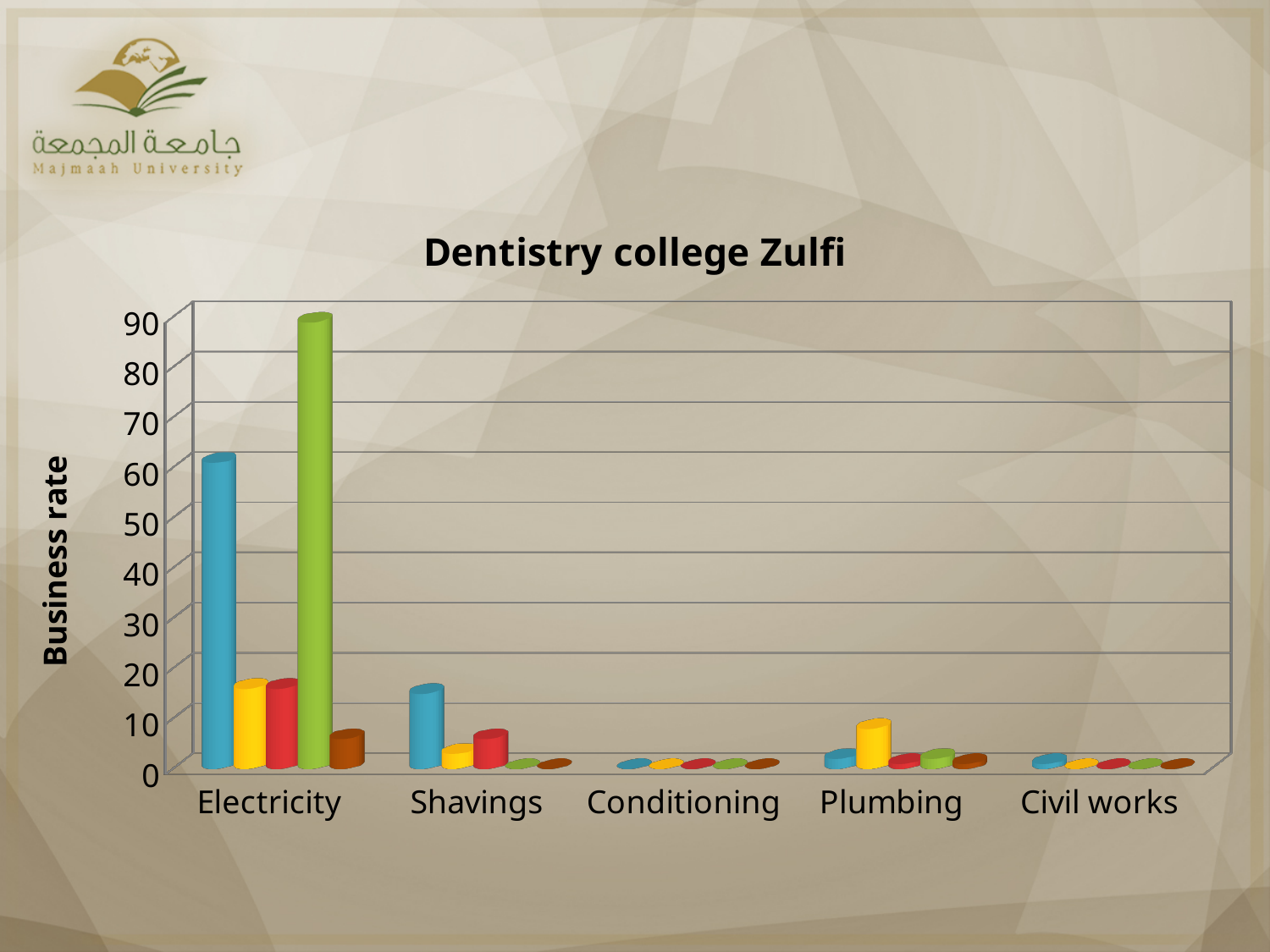
Is the value of the green bar for Electricity greater or less than 80? greater Which category contains the tallest bar in the chart? Electricity What is the title of the chart? Dentistry college Zulfi Which category has the larger blue bar: Electricity or Shavings? Electricity Which category has the larger yellow bar: Plumbing or Civil works? Plumbing Is the value of the blue bar for Electricity greater or less than 50? greater What is the label on the vertical axis of the chart? Business rate How many categories are shown on the x axis of the chart? 5 Which is larger for Electricity: the blue bar or the green bar? the green bar Is the value of the yellow bar for Electricity greater or less than 20? less What kind of chart is shown on the slide? bar chart